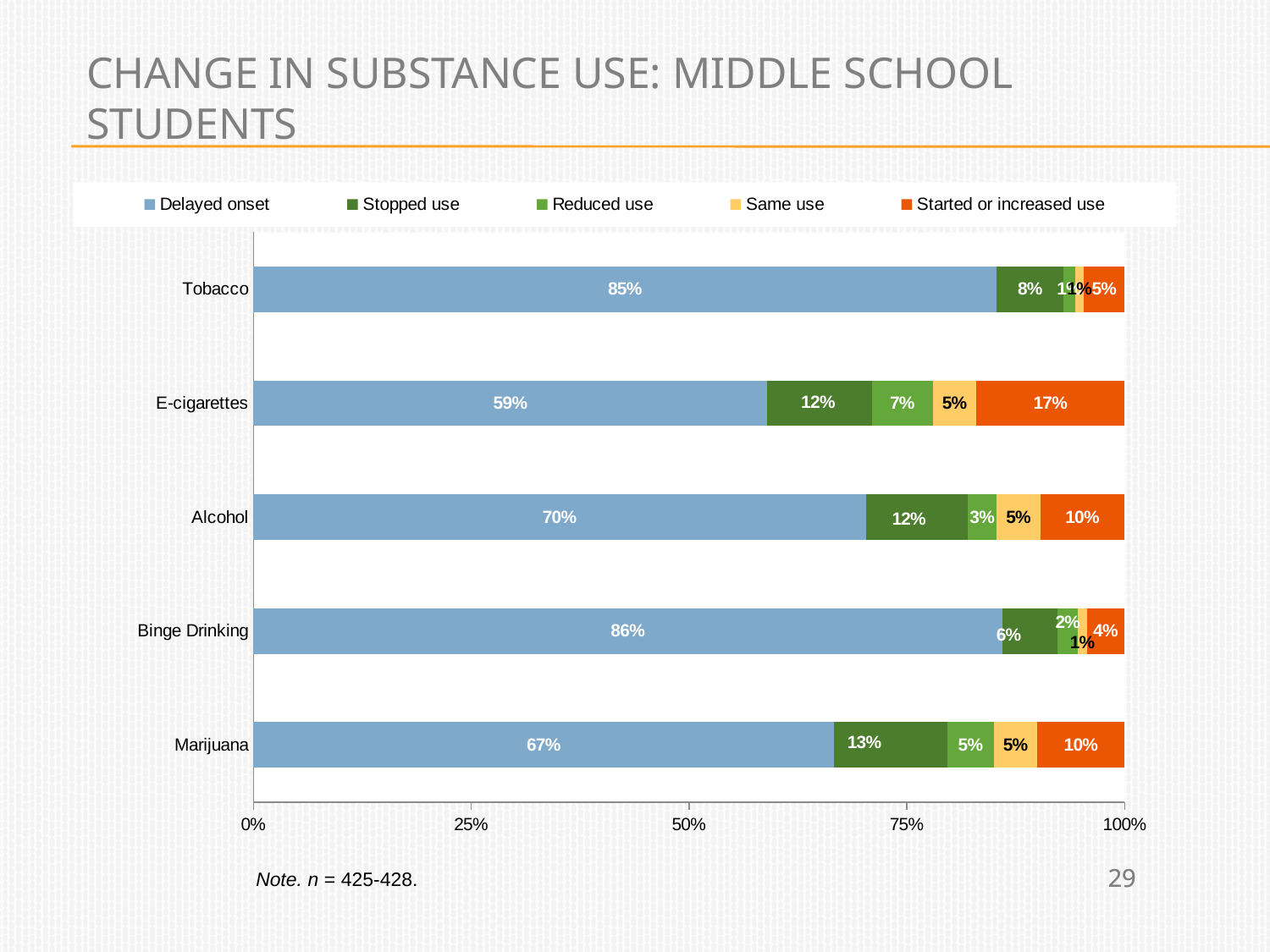
What is the 'Started or increased use' value for E-cigarettes? 17% What is the 'Stopped use' value for Marijuana? 13% What kind of chart is shown on the slide? Stacked bar chart Which legend entry is shown in orange? Started or increased use What is the difference between the 'Delayed onset' values for Alcohol and E-cigarettes? 11% Which is larger: the 'Started or increased use' value for E-cigarettes or for Marijuana? E-cigarettes How many series does the legend list? 5 Which substance has the lowest 'Delayed onset' percentage? E-cigarettes What is the 'Same use' value for Alcohol? 5% What percentage of middle school students reported delayed onset for Tobacco? 85% How many substance categories are shown on the chart? 5 Which substance has the highest 'Delayed onset' percentage? Binge Drinking